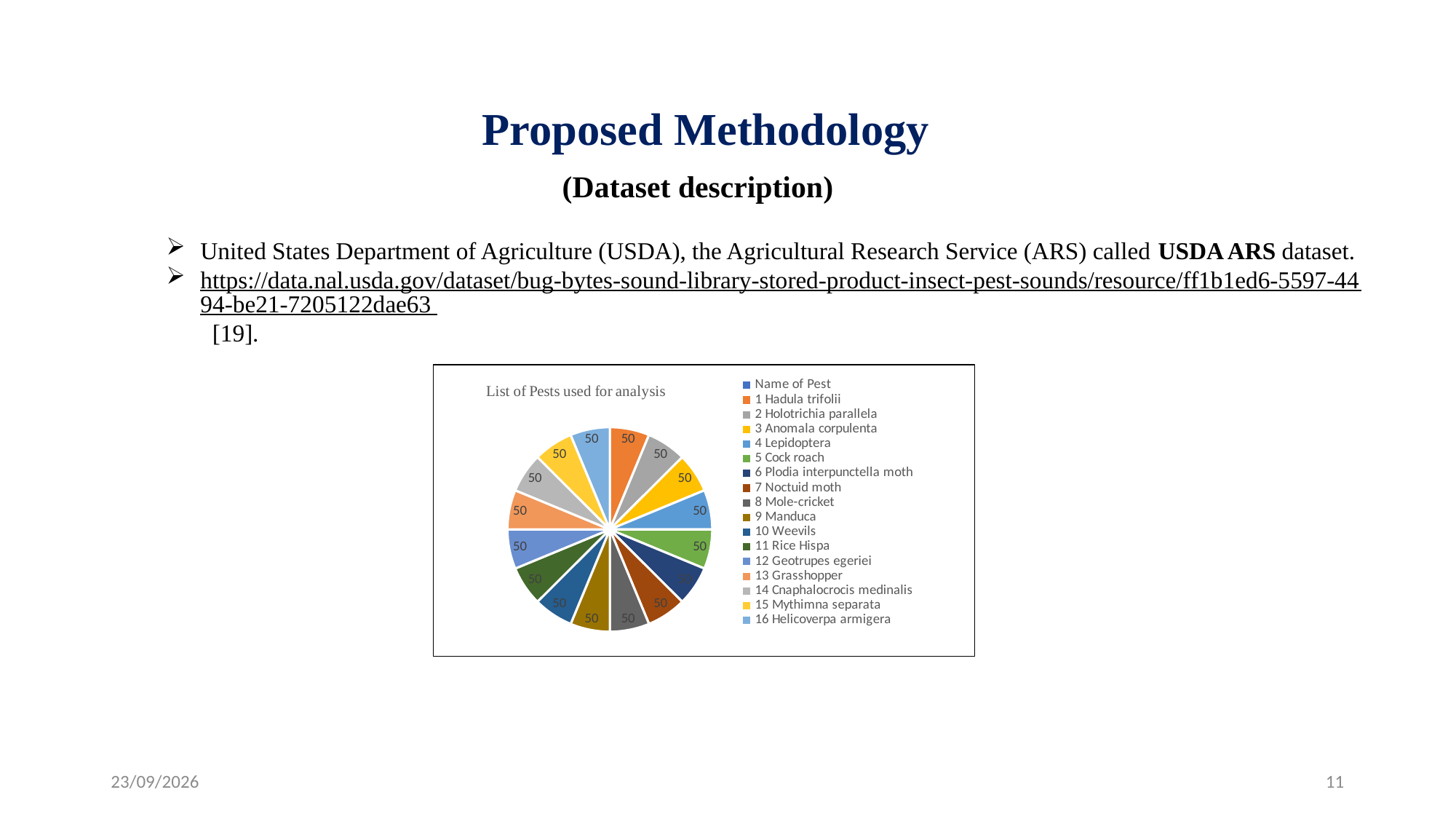
What value is shown for 1 Hadula trifolii in the pie chart? 50 What kind of chart is shown on the slide? Pie chart What value is shown for 13 Grasshopper in the pie chart? 50 Which is larger, the value for 3 Anomala corpulenta or the value for 12 Geotrupes egeriei? They are equal What is the difference between the values for 5 Cock roach and 10 Weevils? 0 What value is shown for 16 Helicoverpa armigera in the pie chart? 50 How many entries does the legend list? 17 What is the title of the chart? List of Pests used for analysis What value is shown for 8 Mole-cricket in the pie chart? 50 Is the value for 7 Noctuid moth greater or less than 100? less Do all the slices in the pie chart have the same value? Yes